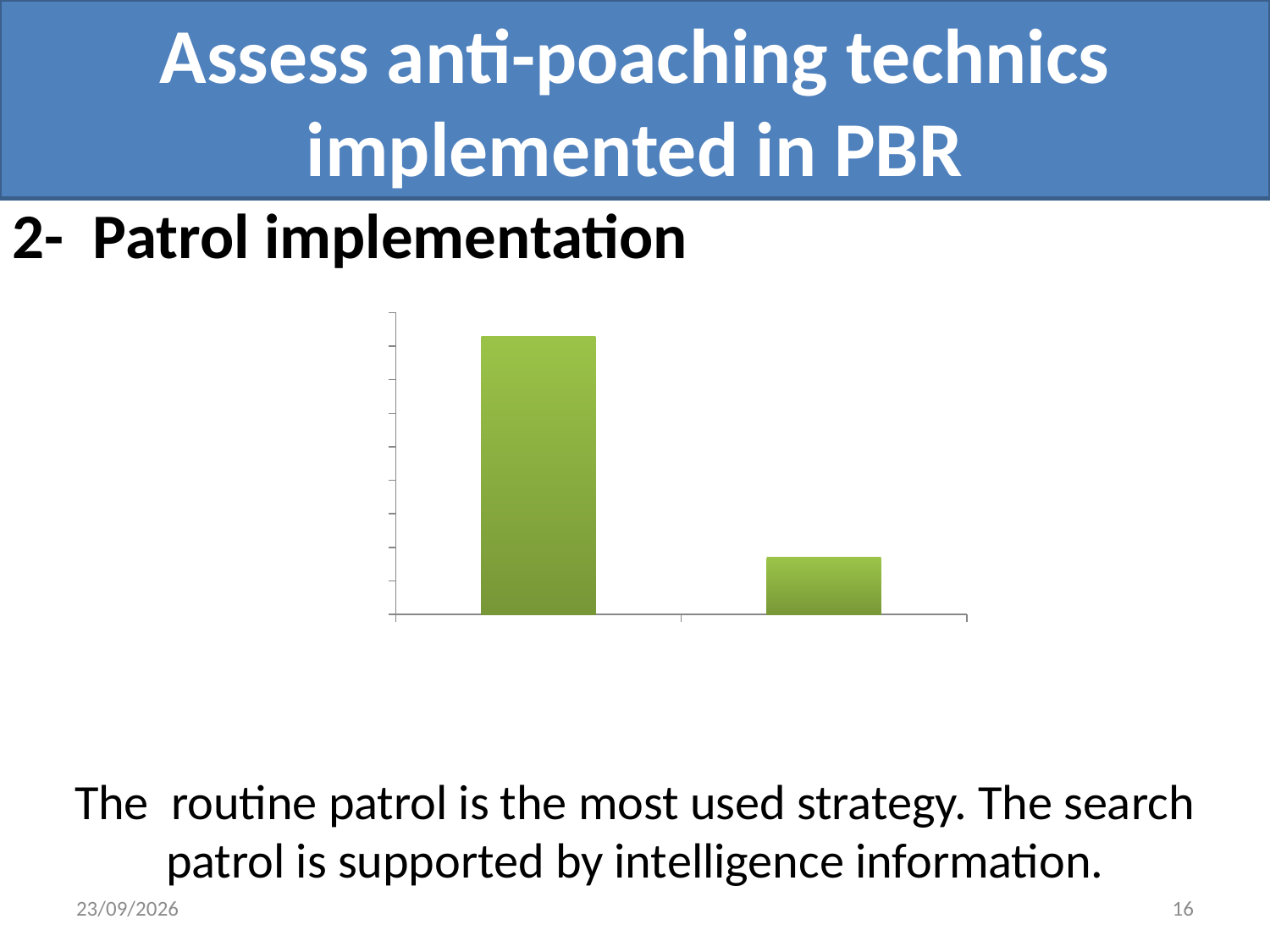
Do the bar values rise or fall from left to right along the x axis? fall How many bars are plotted in the chart? 2 What kind of chart is shown on the slide? bar chart Which bar is taller, the left bar or the right bar? the left bar Does the chart display a legend? No What colour are the bars in the chart? green